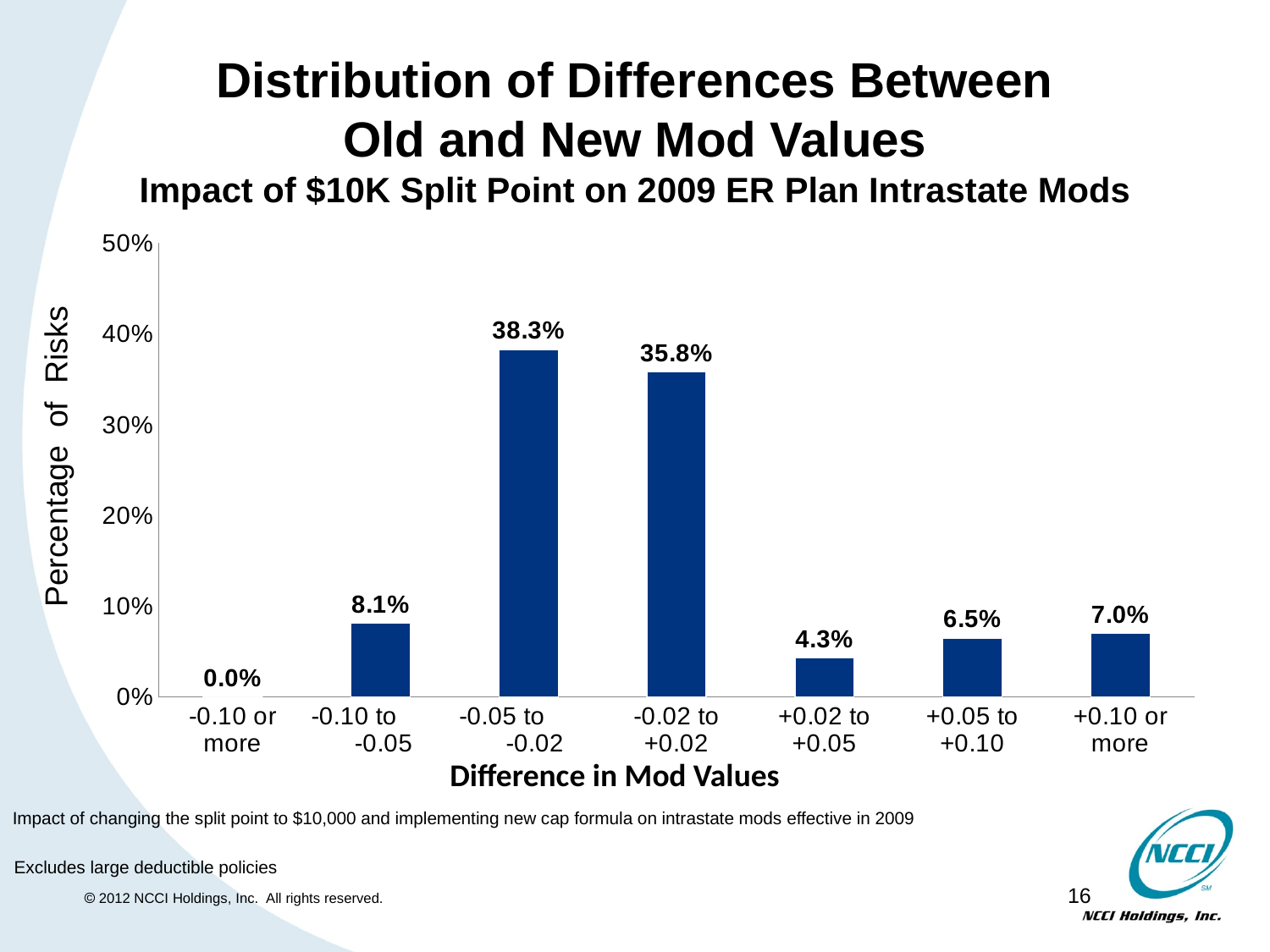
What percentage of risks is shown for the -0.10 or more category? 0.0% Is the value for -0.02 to +0.02 greater or less than 30%? greater Which is larger, the value for -0.10 to -0.05 or the value for +0.10 or more? -0.10 to -0.05 What percentage of risks falls in the -0.05 to -0.02 category? 38.3% How many categories are shown on the x axis? 7 What is the value for the +0.02 to +0.05 category? 4.3% What is the x-axis title of the chart? Difference in Mod Values What kind of chart is shown on the slide? bar chart Which category has the lowest percentage of risks? -0.10 or more What is the y-axis title of the chart? Percentage of Risks What is the difference between the values for -0.05 to -0.02 and -0.02 to +0.02? 2.5% Which category has the highest percentage of risks? -0.05 to -0.02